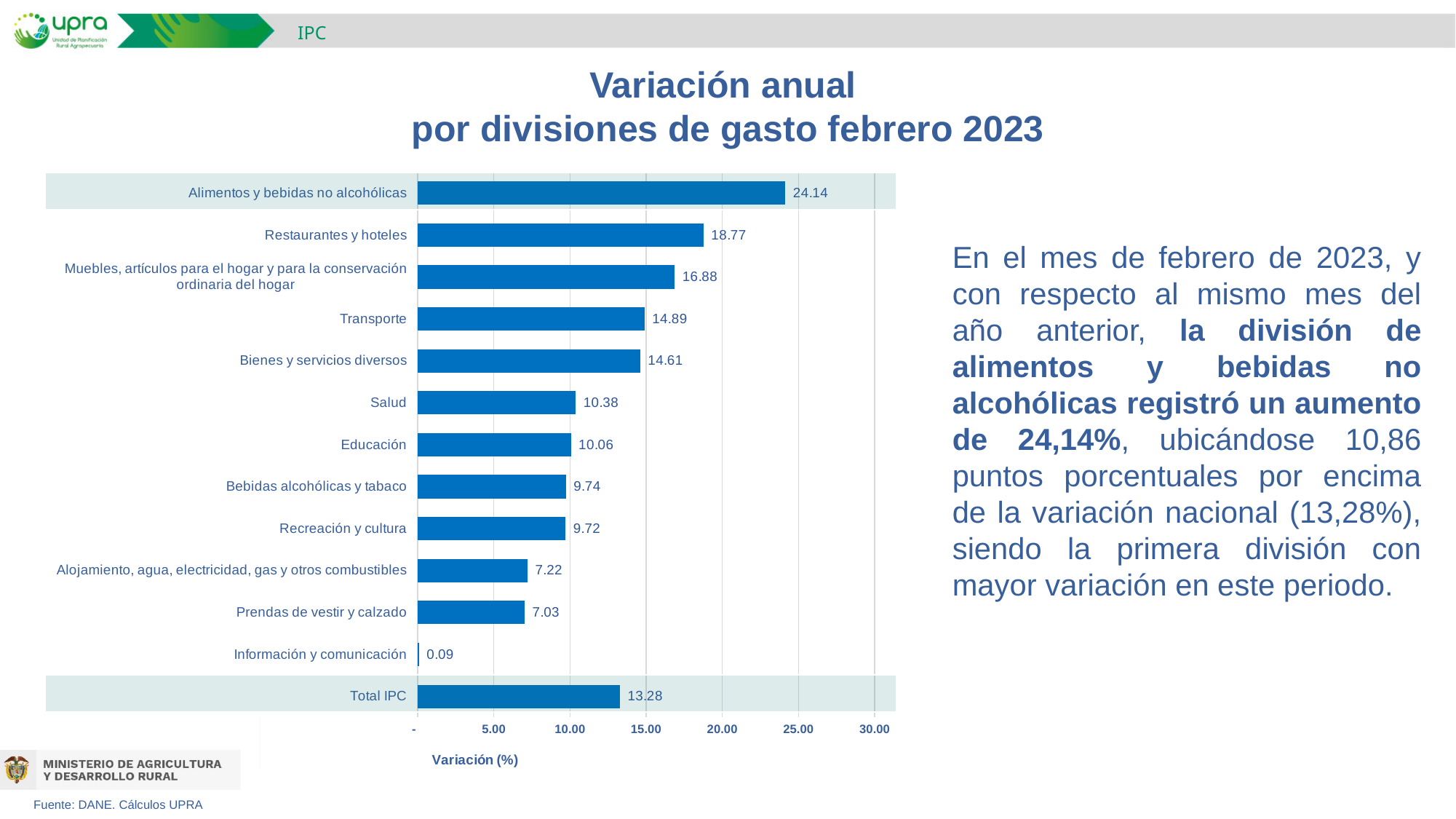
Is the value for Prendas de vestir y calzado greater or less than 10.00? less What kind of chart is shown on the slide? bar chart What is the value for Transporte? 14.89 Which is larger, the value for Salud or the value for Educación? Salud What is the title of the horizontal axis? Variación (%) How many bars are shown in the chart? 13 Which category has the lowest value? Información y comunicación Which category has the highest value? Alimentos y bebidas no alcohólicas What is the value for Alimentos y bebidas no alcohólicas? 24.14 What is the difference between the values for Restaurantes y hoteles and Muebles, artículos para el hogar y para la conservación ordinaria del hogar? 1.89 What is the difference between the values for Alimentos y bebidas no alcohólicas and Total IPC? 10.86 What is the value for Total IPC? 13.28